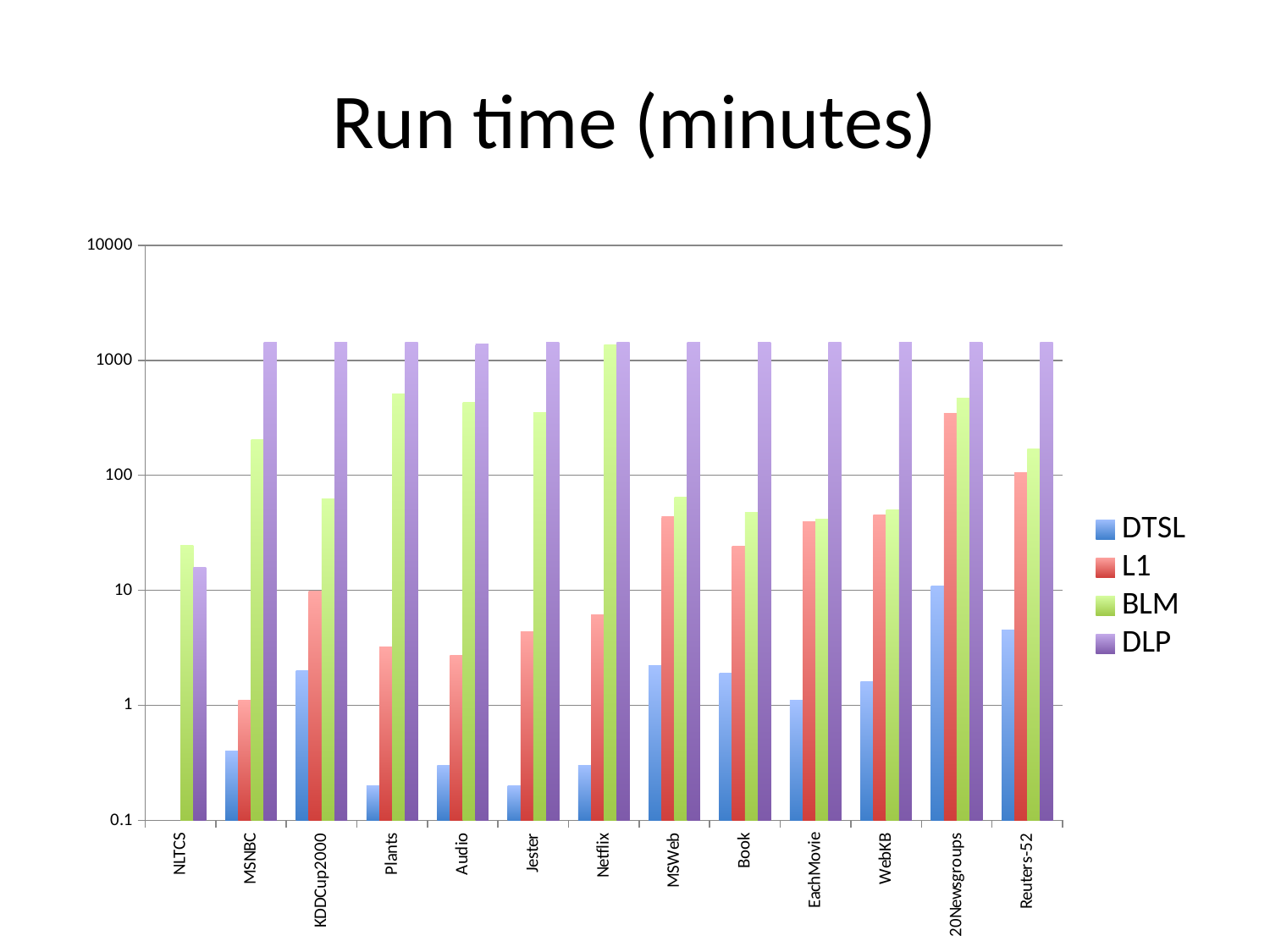
How many datasets (categories) are shown along the x axis? 13 For Netflix, which has the larger run time, BLM or L1? BLM Is the BLM run time for Plants greater or less than 100 minutes? greater For which dataset is the BLM run time lowest? NLTCS Is the DTSL run time for MSNBC greater or less than 1 minute? less What is the title of the chart? Run time (minutes) What kind of chart is shown on the slide? bar chart How many series does the legend list? 4 Is the DLP run time for Plants greater or less than 1000 minutes? greater For which dataset is the DTSL run time highest? 20Newsgroups Which series is shown in purple in the legend? DLP